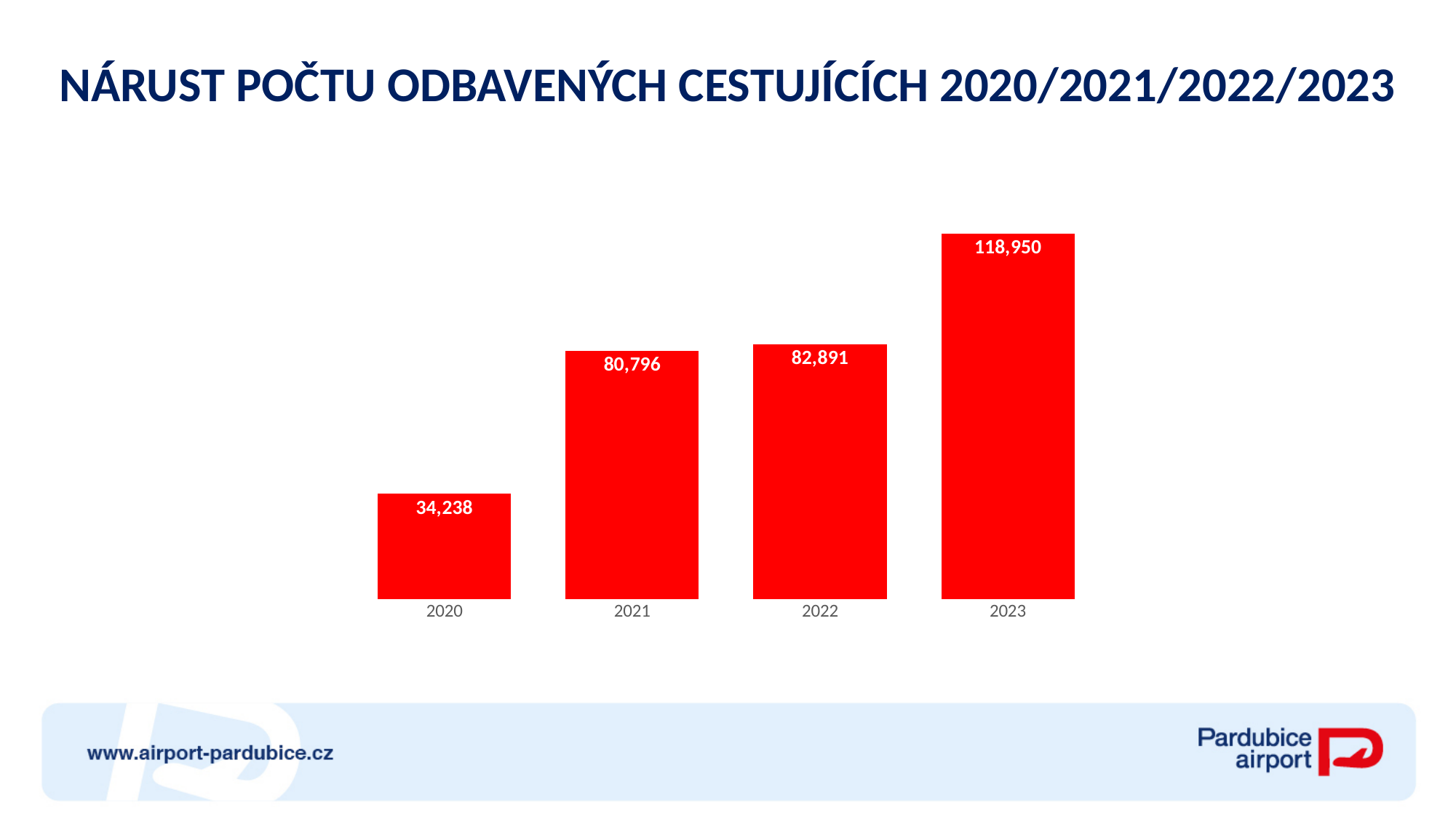
What is the value shown for 2023? 118,950 Which is larger, the value for 2020 or the value for 2023? 2023 How many years are shown on the chart? 4 What is the difference between the values for 2022 and 2021? 2,095 Which year has the highest value? 2023 What is the difference between the values for 2023 and 2022? 36,059 What is the value shown for 2021? 80,796 What is the difference between the values for 2021 and 2020? 46,558 What is the value shown for 2022? 82,891 Which year has the lowest value? 2020 What is the value shown for 2020? 34,238 What kind of chart is shown on the slide? Bar chart